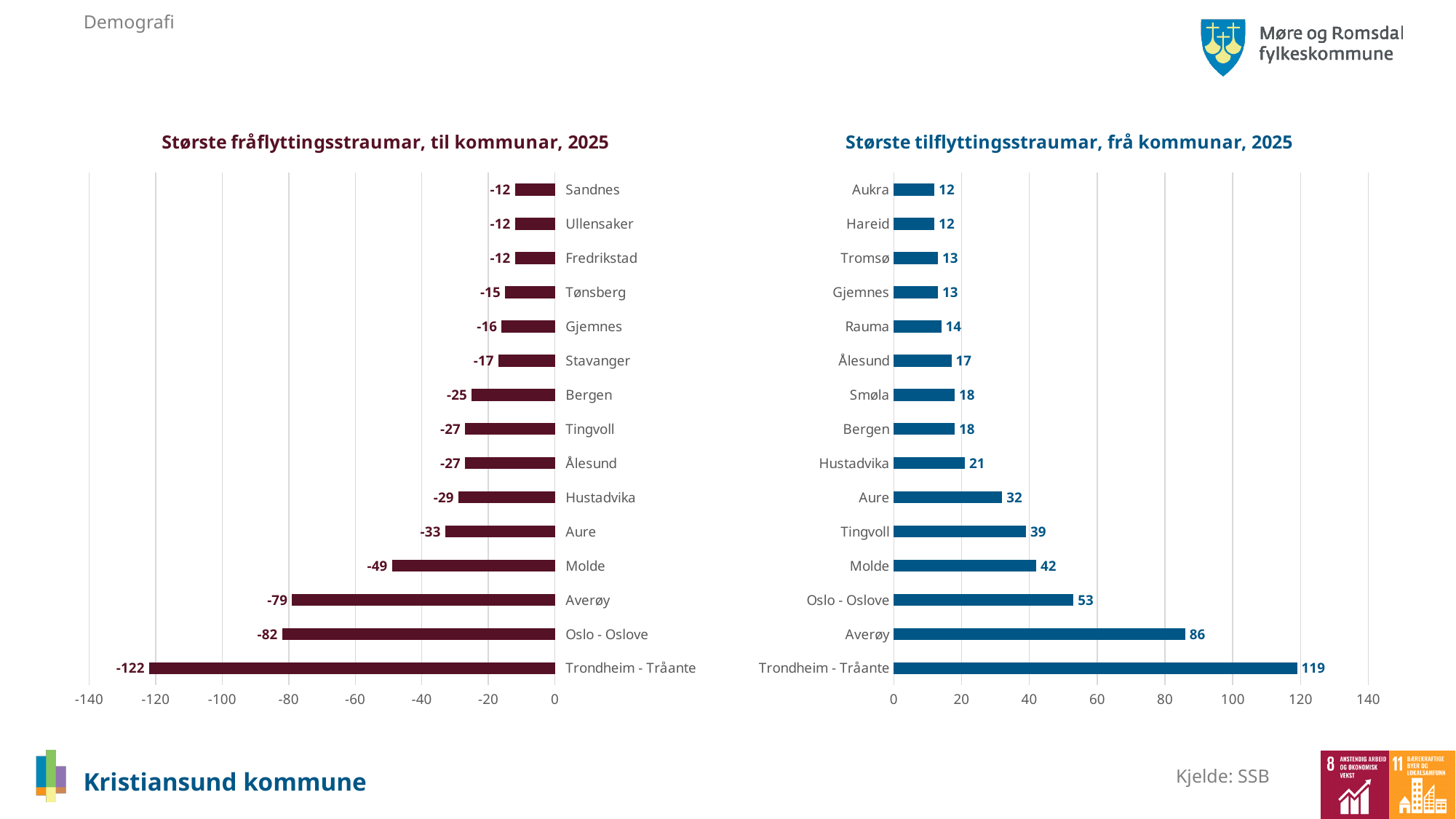
In the chart titled "Største tilflyttingsstraumar, frå kommunar, 2025", what is the value for Averøy? 86 In the chart titled "Største tilflyttingsstraumar, frå kommunar, 2025", what is the difference between the values for Trondheim - Tråante and Averøy? 33 In the chart titled "Største tilflyttingsstraumar, frå kommunar, 2025", which category has the highest value? Trondheim - Tråante In the chart titled "Største tilflyttingsstraumar, frå kommunar, 2025", which is larger, the value for Tingvoll or the value for Molde? Molde In the chart titled "Største tilflyttingsstraumar, frå kommunar, 2025", is the value for Oslo - Oslove greater or less than 60? less How many categories are shown in the chart titled "Største fråflyttingsstraumar, til kommunar, 2025"? 15 What is the title of the chart on the right side of the slide? Største tilflyttingsstraumar, frå kommunar, 2025 What kind of chart is the chart titled "Største tilflyttingsstraumar, frå kommunar, 2025"? Bar chart In the chart titled "Største fråflyttingsstraumar, til kommunar, 2025", which category has the lowest (most negative) value? Trondheim - Tråante In the chart titled "Største fråflyttingsstraumar, til kommunar, 2025", what is the value for Molde? -49 In the chart titled "Største fråflyttingsstraumar, til kommunar, 2025", what is the value for Hustadvika? -29 In the chart titled "Største fråflyttingsstraumar, til kommunar, 2025", what is the difference between the values for Oslo - Oslove and Averøy? 3